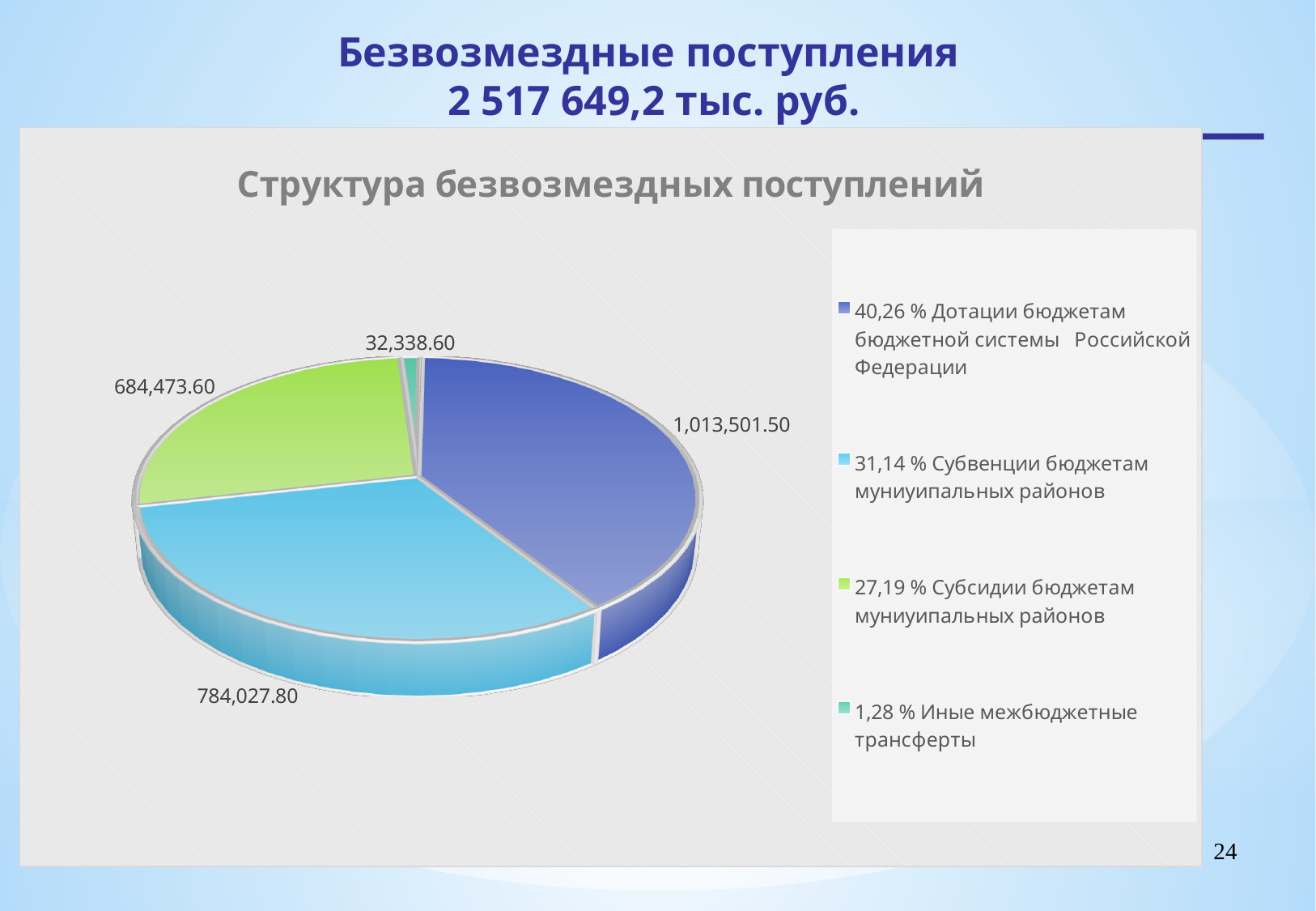
What kind of chart is shown on the slide? Pie chart Which category has the largest slice of the pie? Дотации бюджетам бюджетной системы Российской Федерации What is the title of the chart? Структура безвозмездных поступлений What is the value of the slice for Иные межбюджетные трансферты? 32,338.60 What is the difference between the values for Дотации бюджетам бюджетной системы Российской Федерации and Субвенции бюджетам муниуипальных районов? 229,473.70 What is the value of the slice for Дотации бюджетам бюджетной системы Российской Федерации? 1,013,501.50 Which is larger: the slice for Субвенции бюджетам муниуипальных районов or the slice for Субсидии бюджетам муниуипальных районов? Субвенции бюджетам муниуипальных районов What is the value of the slice for Субсидии бюджетам муниуипальных районов? 684,473.60 What is the value of the slice for Субвенции бюджетам муниуипальных районов? 784,027.80 What share of the pie does Субсидии бюджетам муниуипальных районов represent, according to the legend? 27,19 %